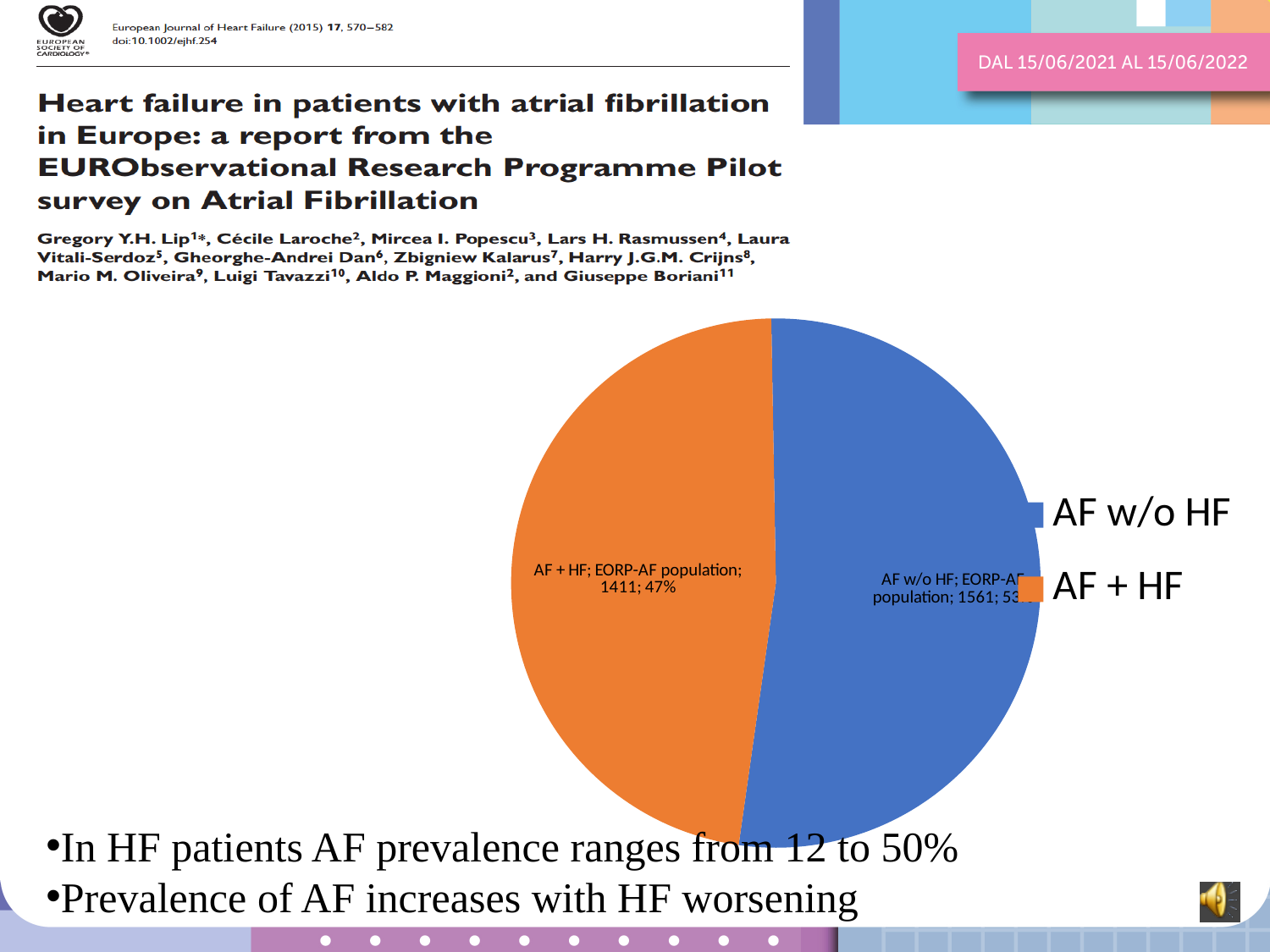
How many slices does the pie chart have? 2 What colour is the AF + HF slice in the pie chart? Orange How many entries does the legend of the pie chart list? 2 What kind of chart is shown on the slide? Pie chart Which slice of the pie chart is the smallest? AF + HF Which group has more patients in the pie chart, AF w/o HF or AF + HF? AF w/o HF What is the number of patients in the AF w/o HF slice of the pie chart? 1561 What is the total number of patients across both slices of the pie chart? 2972 What share of the pie does the AF + HF slice represent? 47% What is the number of patients in the AF + HF slice of the pie chart? 1411 What is the difference in patient numbers between the AF w/o HF slice and the AF + HF slice? 150 Which slice of the pie chart is the largest? AF w/o HF